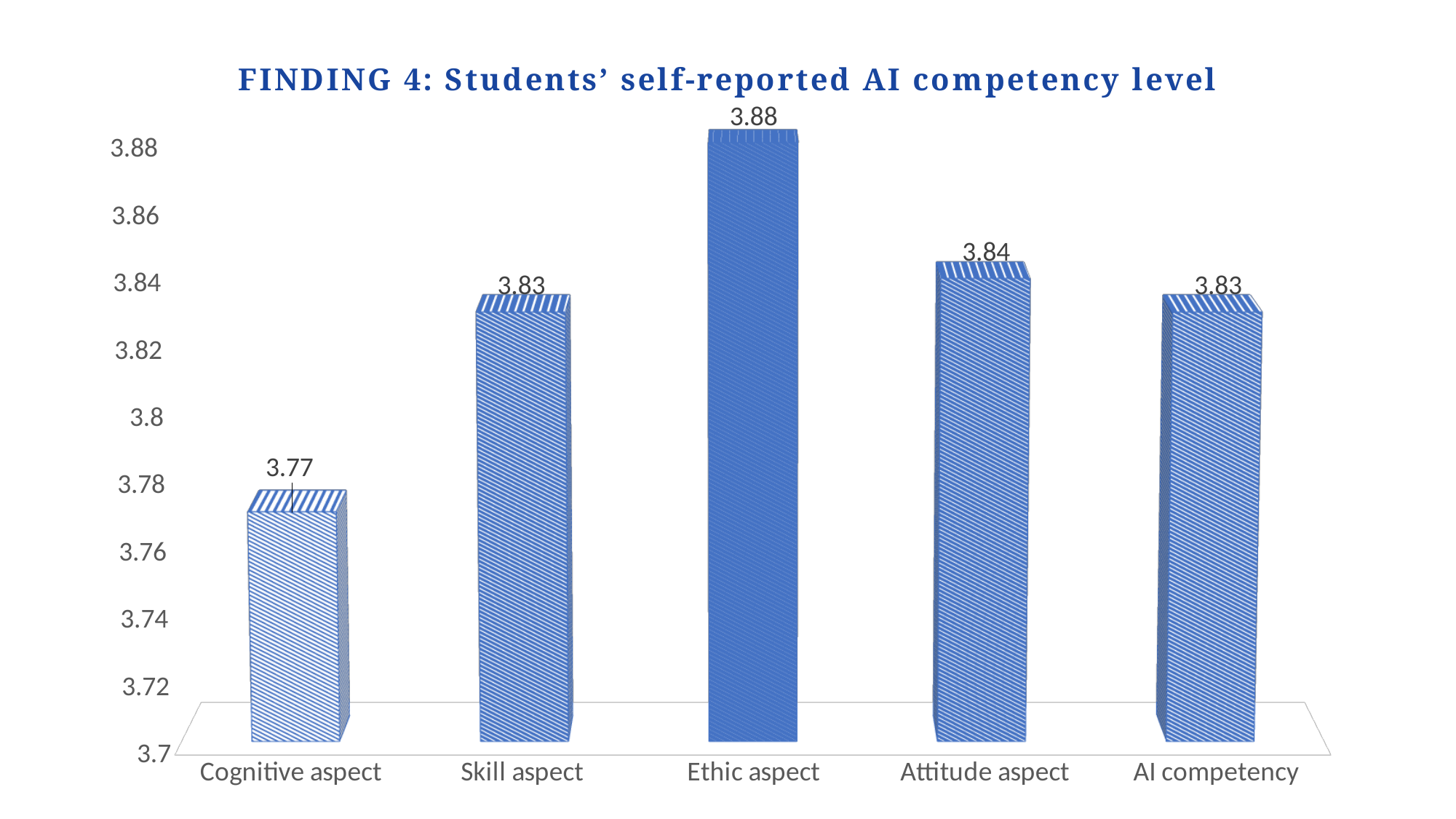
What kind of chart is shown on the slide? Bar chart What is the value for Cognitive aspect? 3.77 Which is larger, the value for Skill aspect or the value for Ethic aspect? Ethic aspect Which category has the highest value? Ethic aspect What is the value for Ethic aspect? 3.88 What is the difference between the values for Ethic aspect and Cognitive aspect? 0.11 What is the title of the chart? FINDING 4: Students' self-reported AI competency level Which category has the lowest value? Cognitive aspect What is the value for Attitude aspect? 3.84 What is the value for AI competency? 3.83 What is the difference between the values for Attitude aspect and Skill aspect? 0.01 How many categories are shown on the x axis? 5